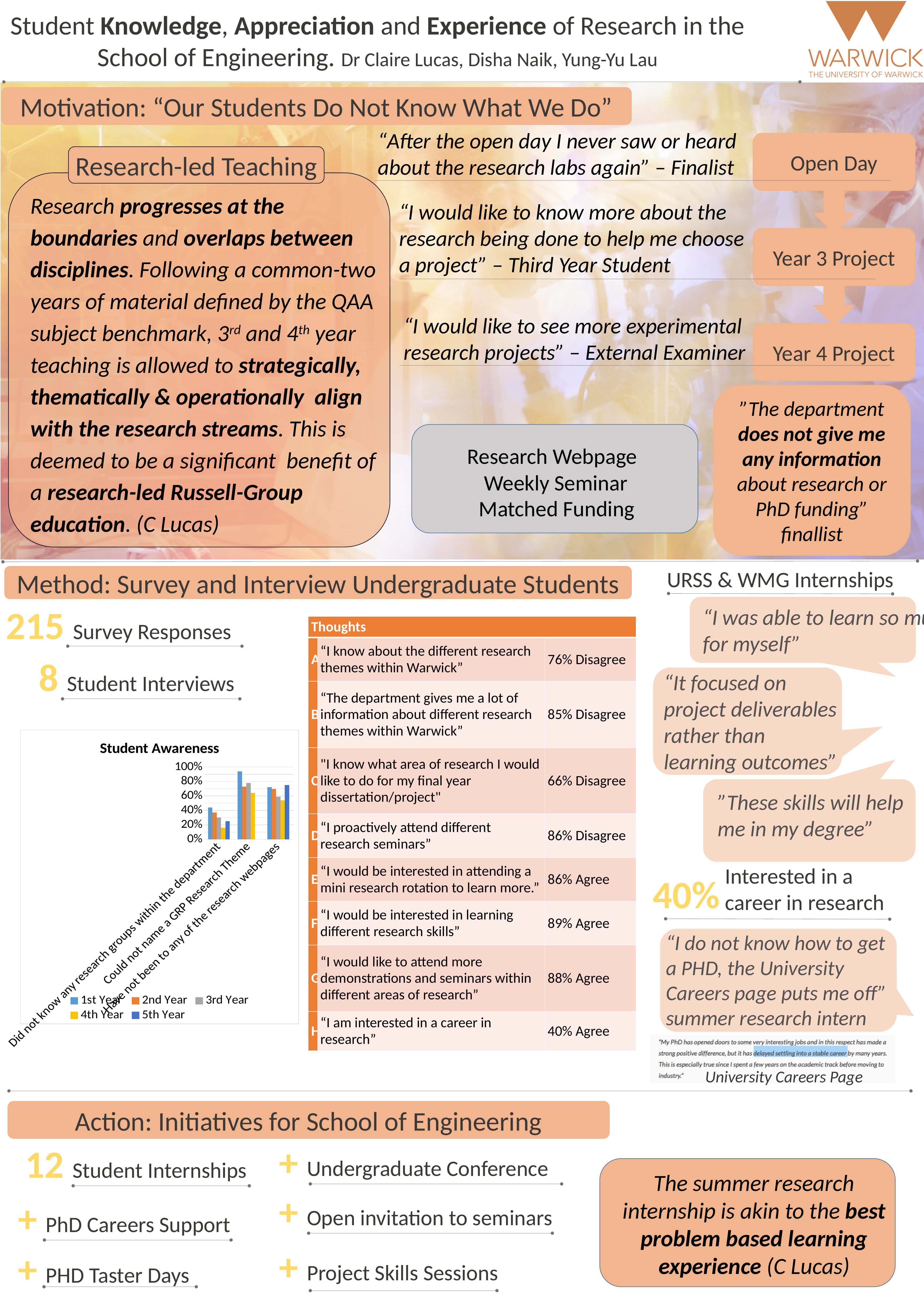
In the Student Awareness chart, which year group has the highest value for 'Did not know any research groups within the department'? 1st Year In the Student Awareness chart, which is larger for 1st Year: 'Could not name a GRP Research Theme' or 'Did not know any research groups within the department'? Could not name a GRP Research Theme In the Student Awareness chart, is the 4th Year value for 'Have not been to any of the research webpages' greater or less than 80%? less What is the title of the chart on the slide? Student Awareness How many categories are shown on the x axis of the Student Awareness chart? 3 Which series in the Student Awareness chart is shown in yellow? 4th Year In the Student Awareness chart, is the 5th Year value for 'Did not know any research groups within the department' greater or less than 40%? less What kind of chart is the Student Awareness chart? bar chart How many series does the legend of the Student Awareness chart list? 5 In the Student Awareness chart, which year group has the highest value for 'Could not name a GRP Research Theme'? 1st Year In the Student Awareness chart, is the 1st Year value for 'Could not name a GRP Research Theme' greater or less than 80%? greater